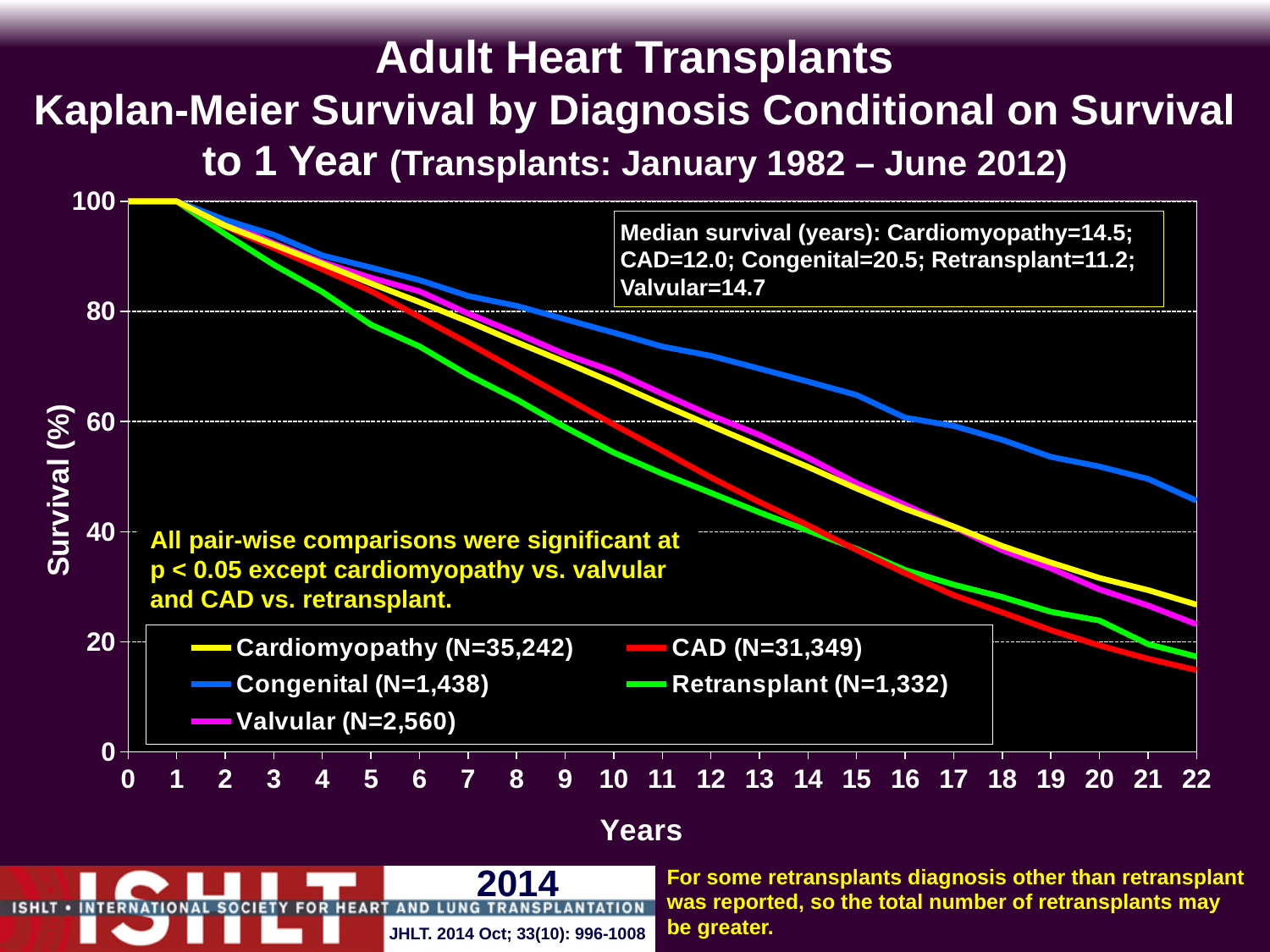
What is the median survival in years for Retransplant patients, as stated on the slide? 11.2 Which diagnosis group has the lowest median survival according to the text box? Retransplant Is the survival for Congenital at year 22 greater or less than 40%? greater Do the survival curves rise or fall as years increase? fall What kind of chart is shown on the slide? line chart How many series does the legend list? 5 Which diagnosis group has the highest median survival according to the text box? Congenital What is the median survival in years for Congenital patients, as stated on the slide? 20.5 At year 22, which has higher survival: Congenital or CAD? Congenital What is the N shown in the legend for Cardiomyopathy? 35,242 Is the survival for CAD at year 22 greater or less than 20%? less What is the difference in median survival (years) between Congenital and CAD? 8.5